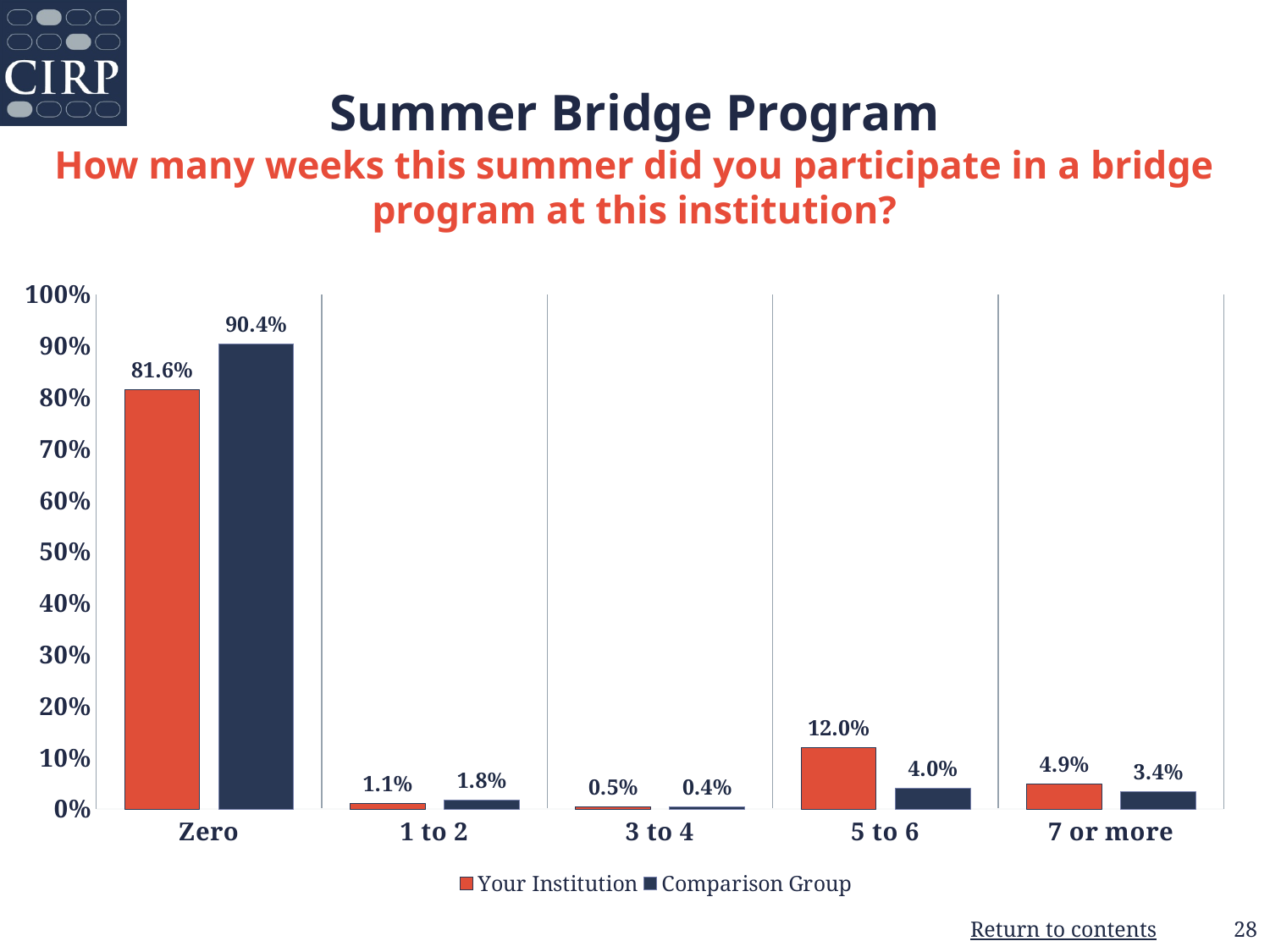
Is the value for Your Institution in the Zero category greater or less than 90%? less Which category has the highest value for Comparison Group? Zero What is the value for Your Institution in the Zero category? 81.6% How many categories are shown on the x axis? 5 What is the value for Your Institution in the 7 or more category? 4.9% Which category has the lowest value for Your Institution? 3 to 4 How many series does the legend list? 2 In the 5 to 6 category, which series has the larger value, Your Institution or Comparison Group? Your Institution What is the value for Comparison Group in the 5 to 6 category? 4.0% Which series is shown in dark navy blue? Comparison Group What kind of chart is shown on the slide? bar chart What is the difference between Comparison Group and Your Institution in the Zero category? 8.8%